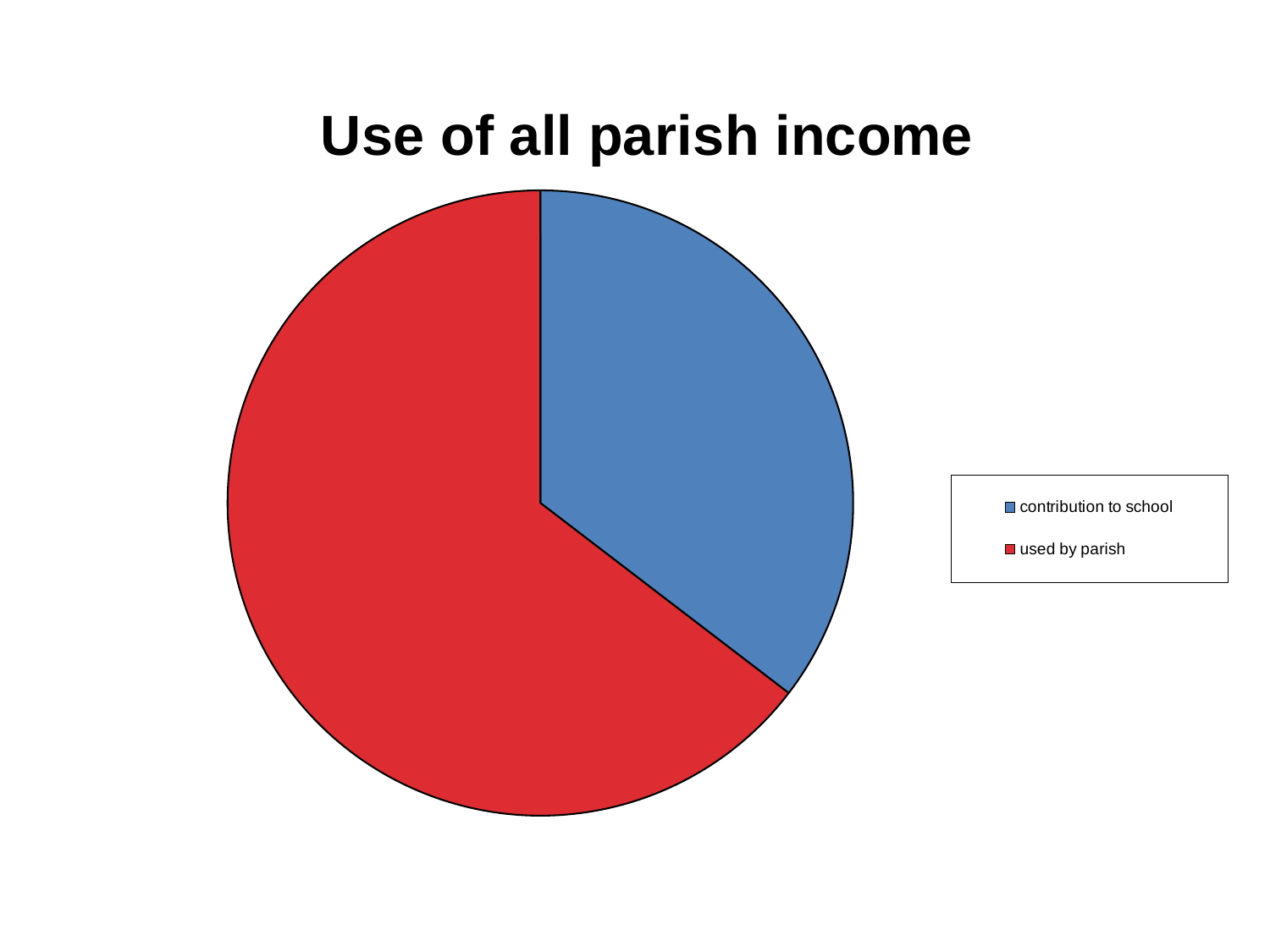
Which slice is the largest? used by parish What is the title of the chart? Use of all parish income How many slices does the pie chart have? 2 Which is larger, the slice for contribution to school or the slice for used by parish? used by parish Which colour represents the contribution to school slice? blue Which slice is the smallest? contribution to school What kind of chart is shown on the slide? pie chart How many entries does the legend list? 2